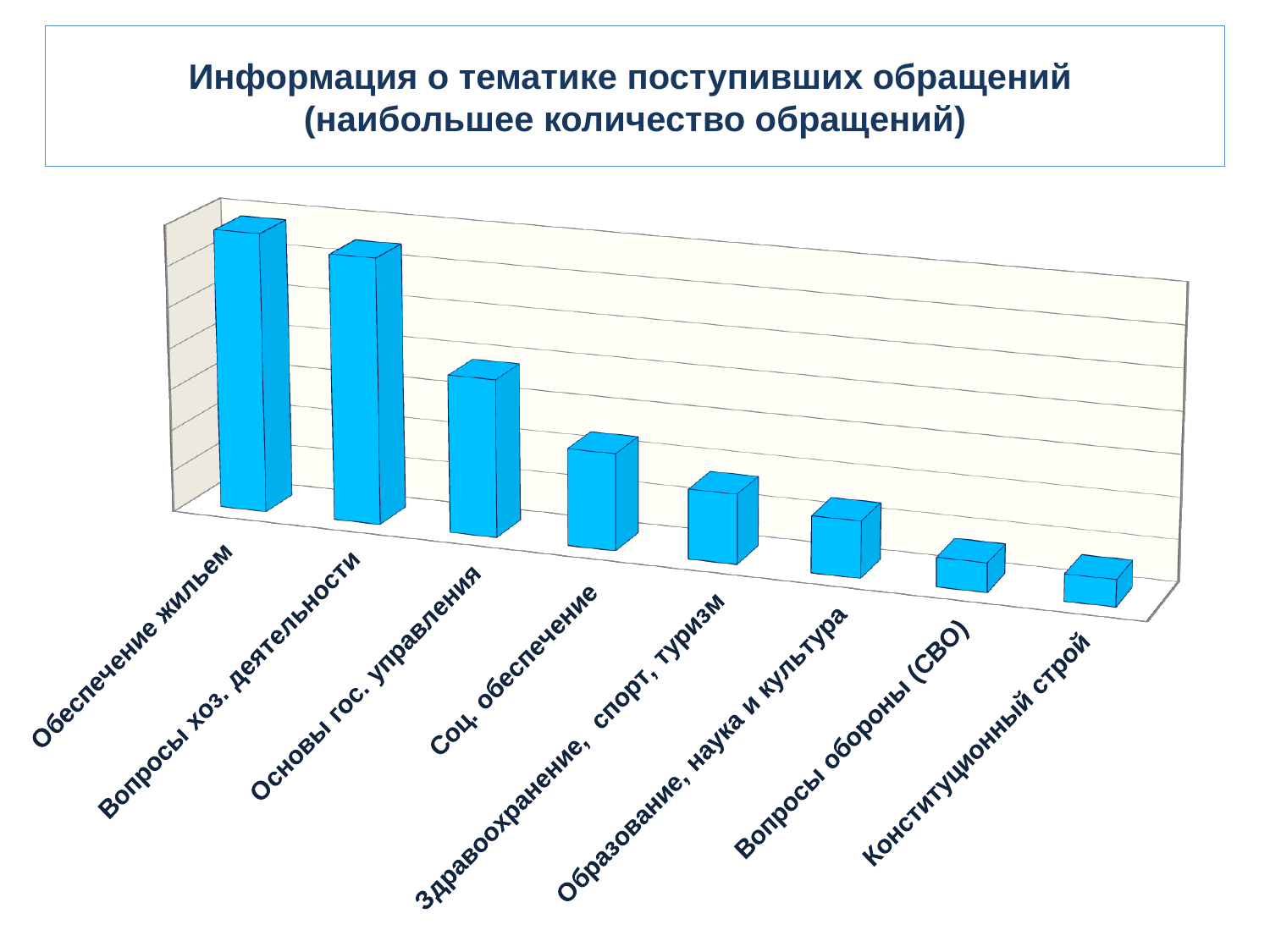
What colour are the bars in the chart? blue Which category has the highest bar in the chart? Обеспечение жильем Which has the taller bar: Основы гос. управления or Соц. обеспечение? Основы гос. управления What is the title of the chart on the slide? Информация о тематике поступивших обращений (наибольшее количество обращений) How many categories are plotted in the chart? 8 Do the bar heights rise or fall from left to right along the x axis? fall What kind of chart is shown on the slide? bar chart Which has the taller bar: Вопросы хоз. деятельности or Образование, наука и культура? Вопросы хоз. деятельности Which has the taller bar: Здравоохранение, спорт, туризм or Вопросы обороны (СВО)? Здравоохранение, спорт, туризм Which category has the lowest bar in the chart? Конституционный строй